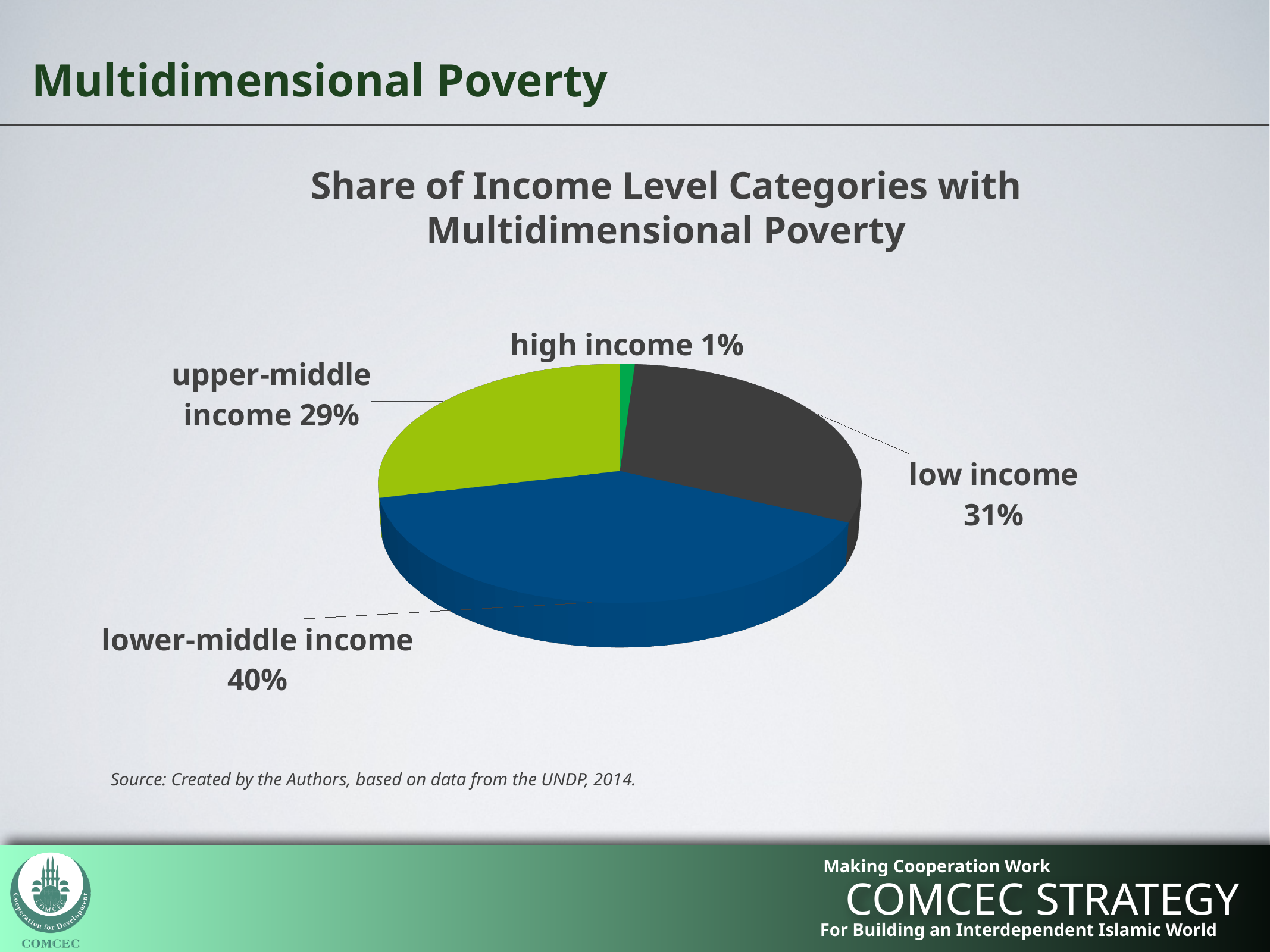
What share of the pie does high income hold? 1% What share of the pie does low income hold? 31% What share of the pie does lower-middle income hold? 40% Which income level category has the smallest share? high income What share of the pie does upper-middle income hold? 29% Which has a larger share, upper-middle income or lower-middle income? lower-middle income What is the difference in share between low income and upper-middle income? 2% What is the difference in share between lower-middle income and low income? 9% Which income level category has the largest share? lower-middle income How many income level categories are shown in the pie chart? 4 What kind of chart is shown on the slide? pie chart What is the title of the chart? Share of Income Level Categories with Multidimensional Poverty